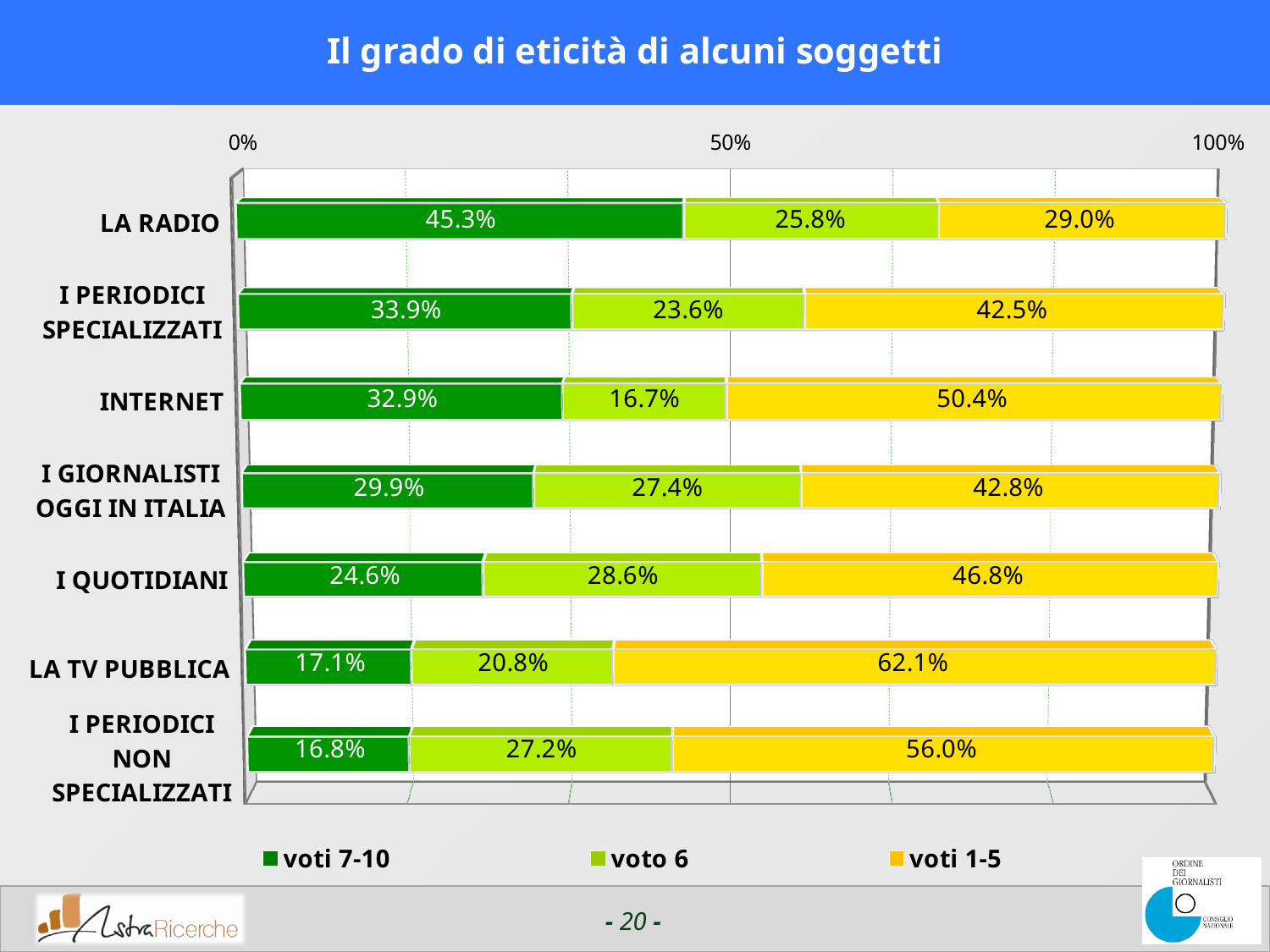
Which category has the lowest 'voto 6' value? INTERNET How many categories are shown on the chart? 7 How many series does the legend list? 3 What is the value of 'voto 6' for I GIORNALISTI OGGI IN ITALIA? 27.4% What is the value of 'voti 7-10' for LA RADIO? 45.3% What is the difference between the 'voti 1-5' value for LA TV PUBBLICA and for LA RADIO? 33.1% What kind of chart is shown on the slide? Stacked bar chart What is the title of the chart? Il grado di eticità di alcuni soggetti Which category has the highest 'voti 7-10' value? LA RADIO Which category has the highest 'voti 1-5' value? LA TV PUBBLICA What is the value of 'voti 1-5' for LA TV PUBBLICA? 62.1% Which has a larger 'voti 1-5' value, INTERNET or I QUOTIDIANI? INTERNET